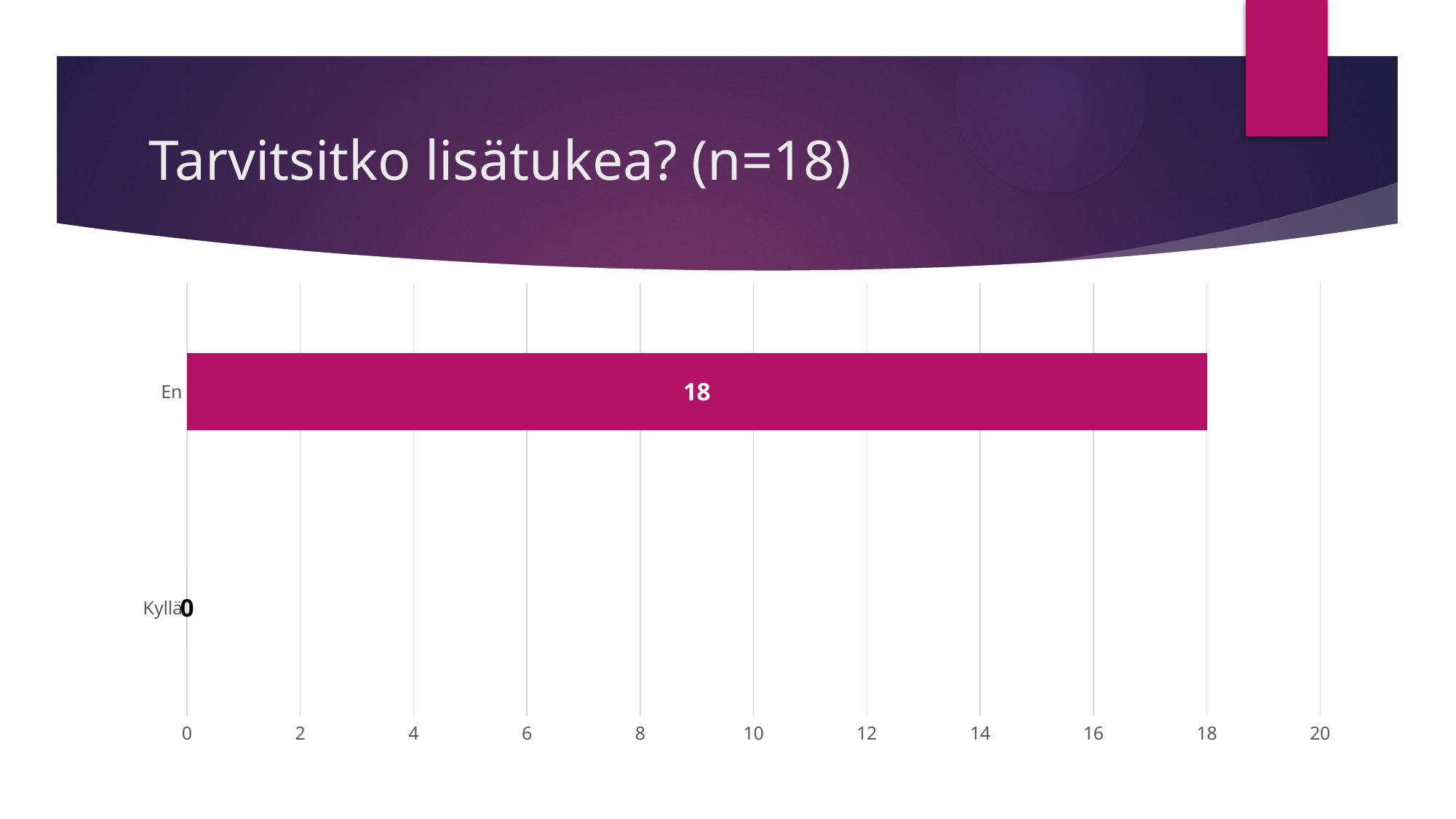
Which category has the lowest value? Kyllä What is the title of the slide? Tarvitsitko lisätukea? (n=18) What is the total of the values for "En" and "Kyllä"? 18 Is the value for "En" greater or less than 10? greater What is the highest value shown on the x axis? 20 Which category has the highest value? En Which is larger, the value for "En" or the value for "Kyllä"? En How many categories are shown on the chart? 2 What is the value for "En"? 18 What kind of chart is shown on the slide? bar chart What is the value for "Kyllä"? 0 What is the difference between the values for "En" and "Kyllä"? 18